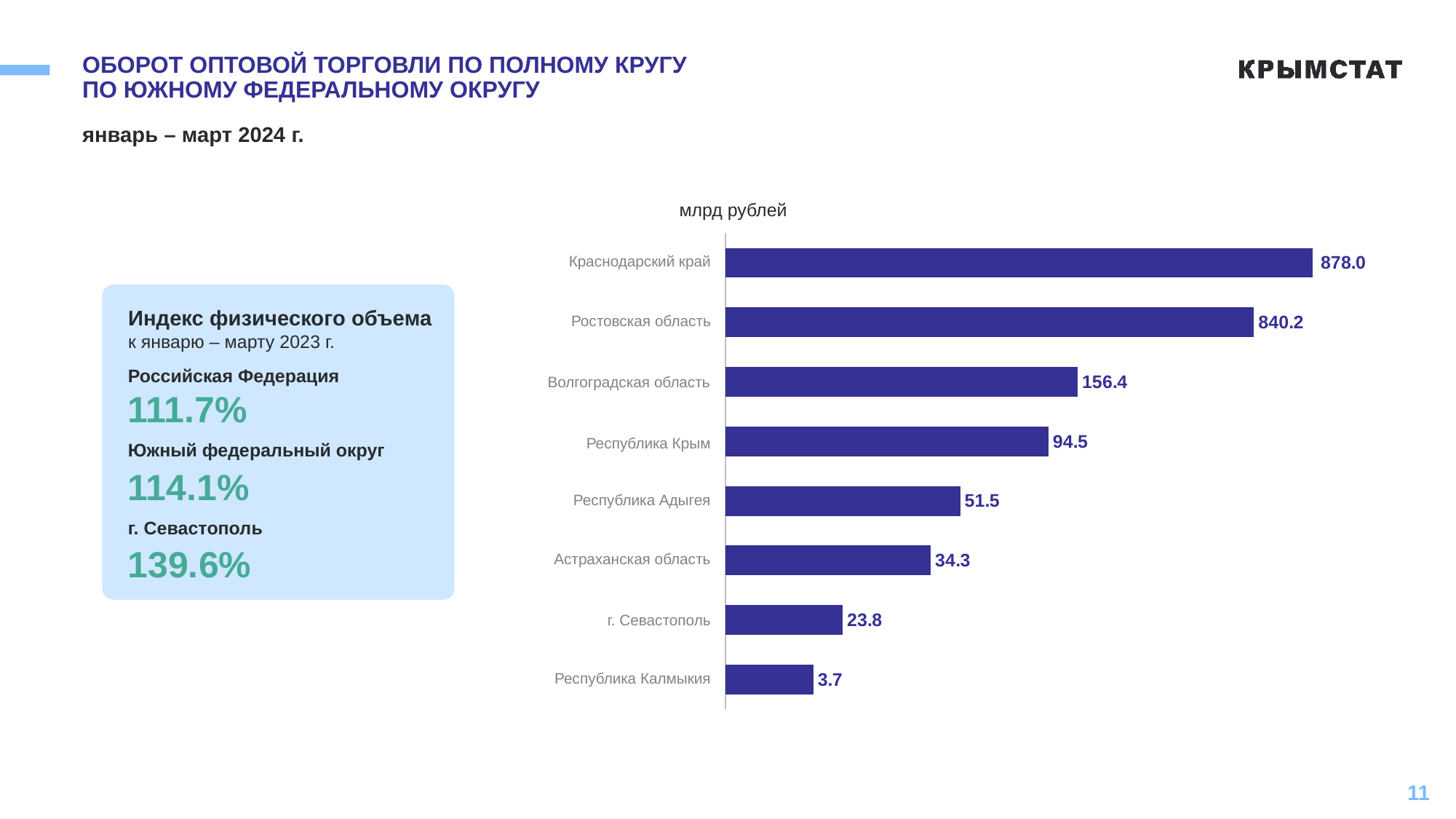
Which region has the lowest value? Республика Калмыкия What is the value for Краснодарский край? 878.0 What is the value for Астраханская область? 34.3 What is the difference between the values for Краснодарский край and Ростовская область? 37.8 Which is larger, the value for Волгоградская область or the value for Республика Адыгея? Волгоградская область What unit is shown above the chart? млрд рублей What is the value for г. Севастополь? 23.8 Which region has the highest value? Краснодарский край What kind of chart is shown on the slide? bar chart What is the difference between the values for Республика Крым and г. Севастополь? 70.7 What is the value for Республика Крым? 94.5 How many regions are shown in the chart? 8